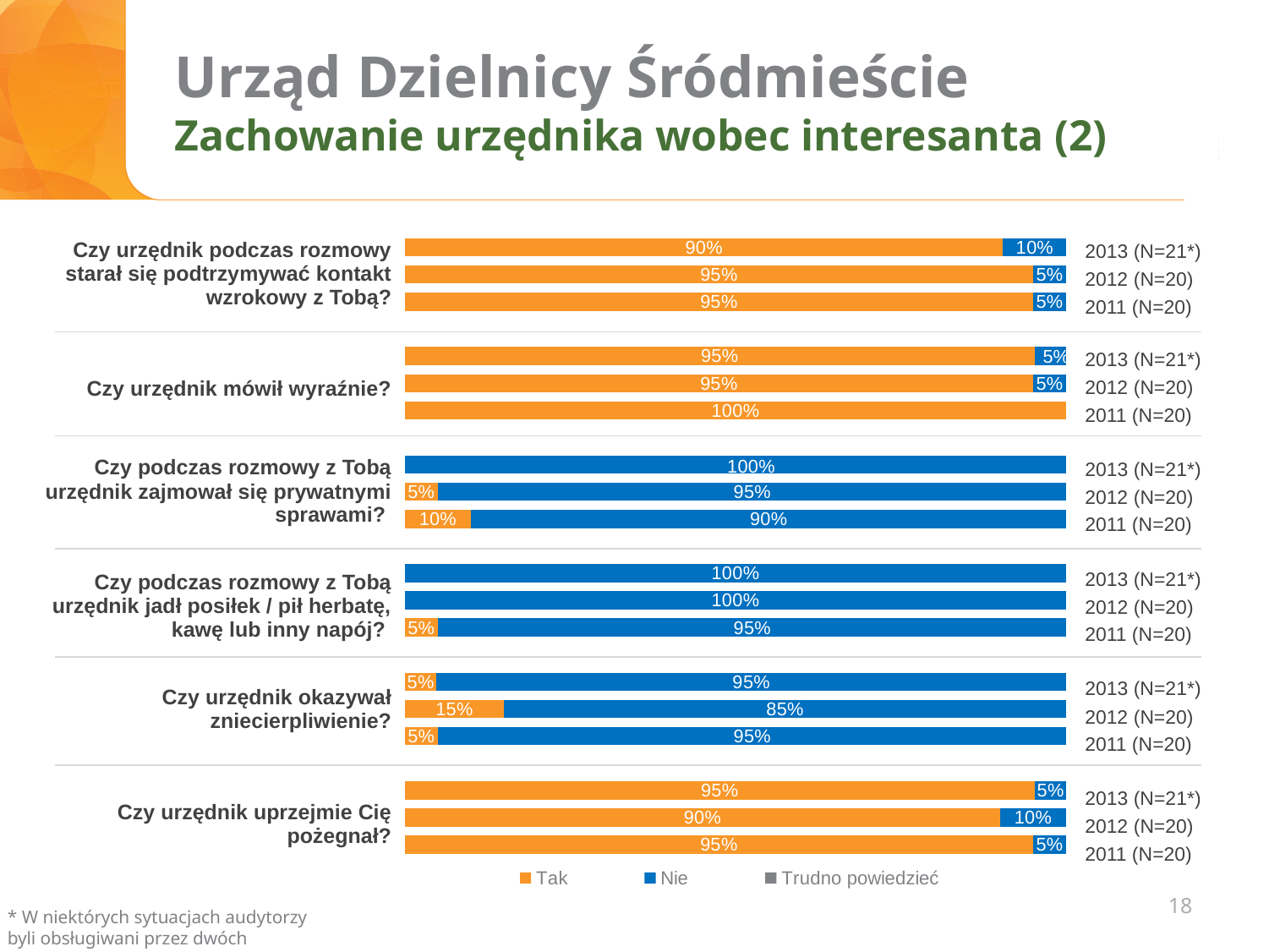
What are the legend entries of the chart? Tak, Nie, Trudno powiedzieć How many series does the legend list? 3 What is the 'Tak' value for 'Czy urzędnik mówił wyraźnie?' in 2011 (N=20)? 100% For 'Czy urzędnik okazywał zniecierpliwienie?', which year has the larger 'Nie' value: 2012 or 2013? 2013 What kind of chart is shown on the slide? Stacked bar chart How many questions (categories) are shown in the chart? 6 What is the 'Nie' value for 'Czy urzędnik uprzejmie Cię pożegnał?' in 2012 (N=20)? 10% What is the 'Tak' value for 'Czy podczas rozmowy z Tobą urzędnik zajmował się prywatnymi sprawami?' in 2011 (N=20)? 10% Which colour represents 'Tak' in the chart? Orange What is the 'Tak' value for 'Czy urzędnik okazywał zniecierpliwienie?' in 2012 (N=20)? 15% For 'Czy urzędnik podczas rozmowy starał się podtrzymywać kontakt wzrokowy z Tobą?', what is the difference between the 'Tak' value in 2012 (95%) and in 2013 (90%)? 5 percentage points What is the total of the stacked bar for 'Czy urzędnik podczas rozmowy starał się podtrzymywać kontakt wzrokowy z Tobą?' in 2013 (N=21*)? 100%